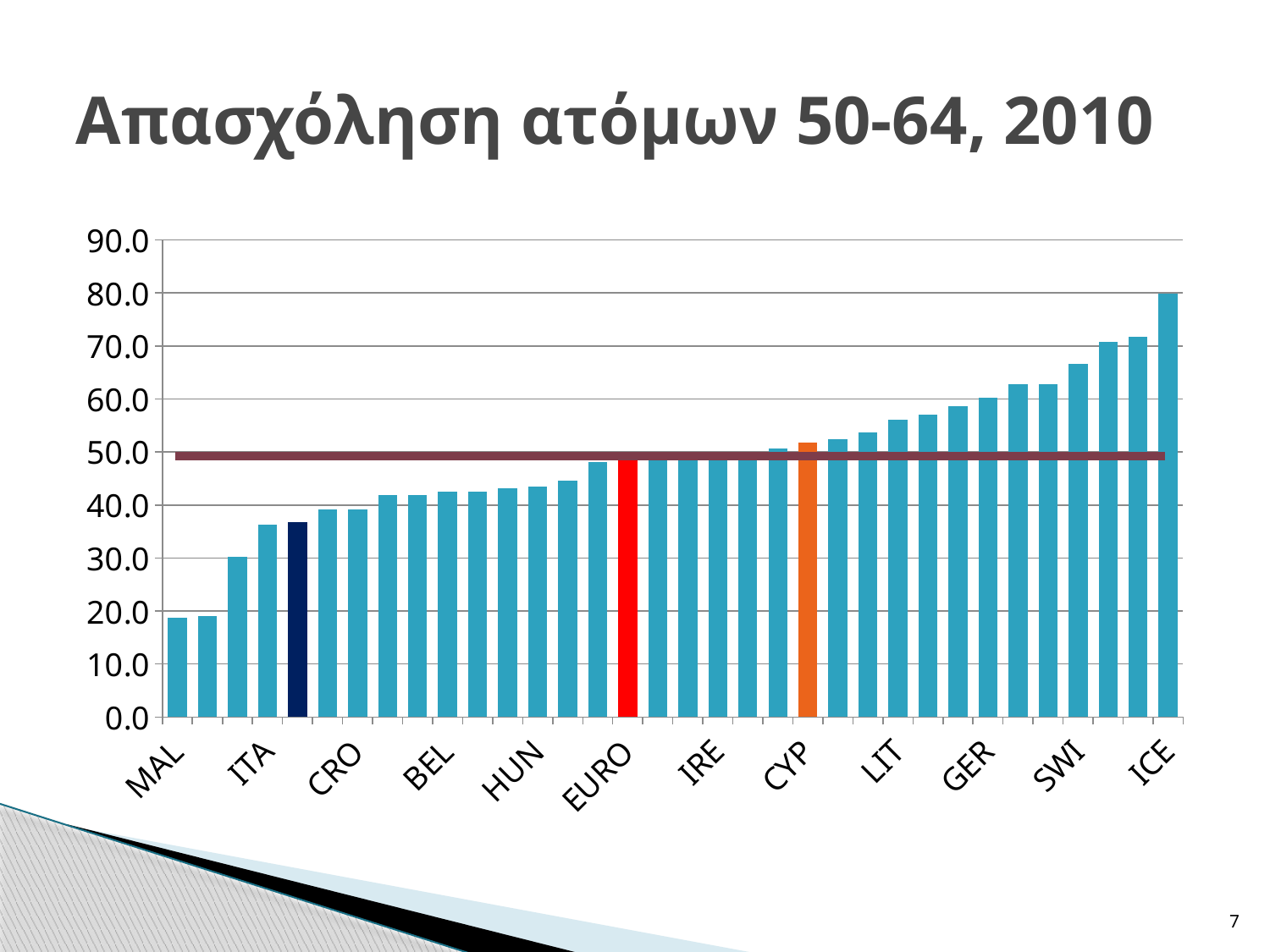
Which labelled category has the highest value? ICE What kind of chart is shown on the slide? Bar chart Is the value for SWI greater or less than 60.0? greater Is the value for HUN greater or less than 50.0? less Is the value for ICE greater or less than 70.0? greater Which is larger, the value for MAL or the value for ICE? ICE Which is larger, the value for GER or the value for BEL? GER Do the bar values generally rise or fall from left to right along the x axis? Rise What is the title of the chart? Απασχόληση ατόμων 50-64, 2010 What colour is the bar for EURO? Red